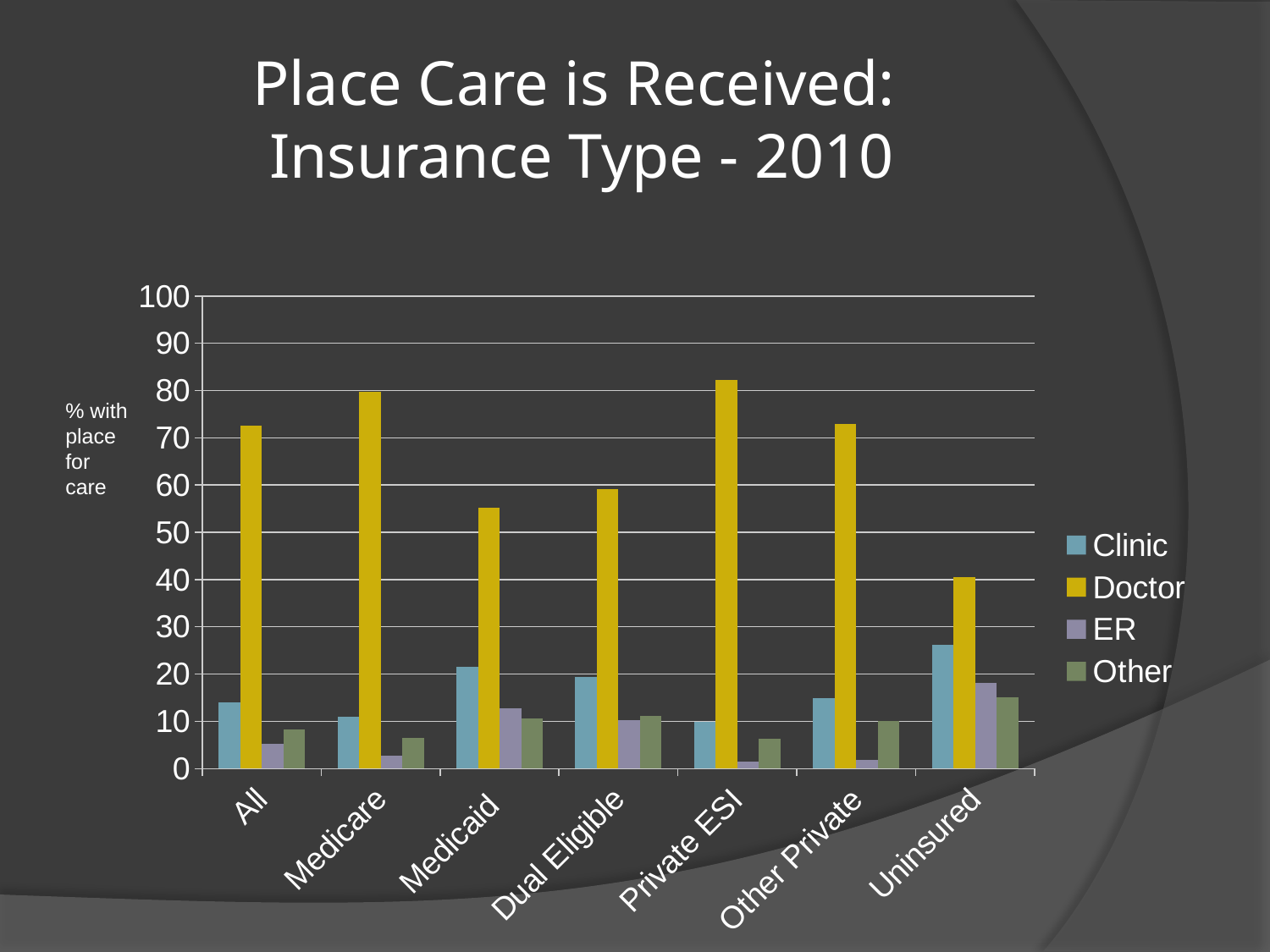
How many series does the legend list? 4 Is the Doctor value for Medicaid greater or less than 60? less How many insurance type categories are shown on the x axis? 7 Is the Doctor value for Uninsured greater or less than 50? less What kind of chart is shown on the slide? bar chart Which insurance type has the highest ER value? Uninsured Which insurance type has the lowest Doctor value? Uninsured For Uninsured, which is larger, the Clinic value or the ER value? Clinic Which is larger, the Doctor value for Medicare or the Doctor value for Medicaid? Medicare Is the Clinic value for Uninsured greater or less than 20? greater Which insurance type has the highest Clinic value? Uninsured Which insurance type has the highest Doctor value? Private ESI